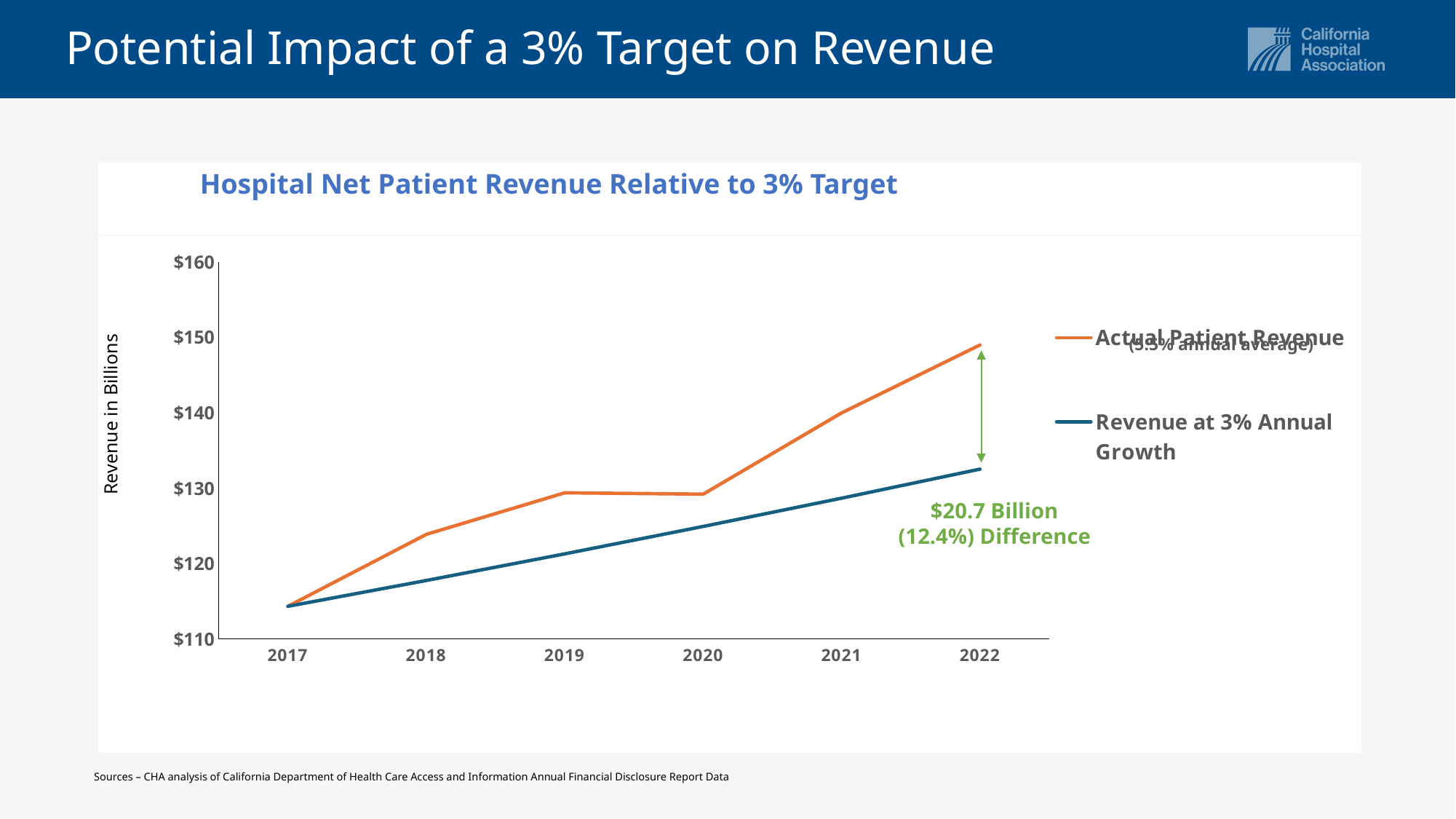
What is the difference between Actual Patient Revenue and Revenue at 3% Annual Growth in 2022, as annotated on the chart? $20.7 Billion Is the Revenue at 3% Annual Growth value for 2022 greater or less than $140? less Does the Actual Patient Revenue line generally rise or fall from 2017 to 2022? rise What kind of chart is shown on the slide? line chart What is the title of the chart? Hospital Net Patient Revenue Relative to 3% Target How many years are plotted along the x axis? 6 How many series does the legend list? 2 In which year is Actual Patient Revenue highest? 2022 What is the label on the vertical axis? Revenue in Billions Does the Revenue at 3% Annual Growth line rise or fall from 2017 to 2022? rise In which year is Actual Patient Revenue lowest? 2017 Is the Actual Patient Revenue value for 2022 greater or less than $140? greater